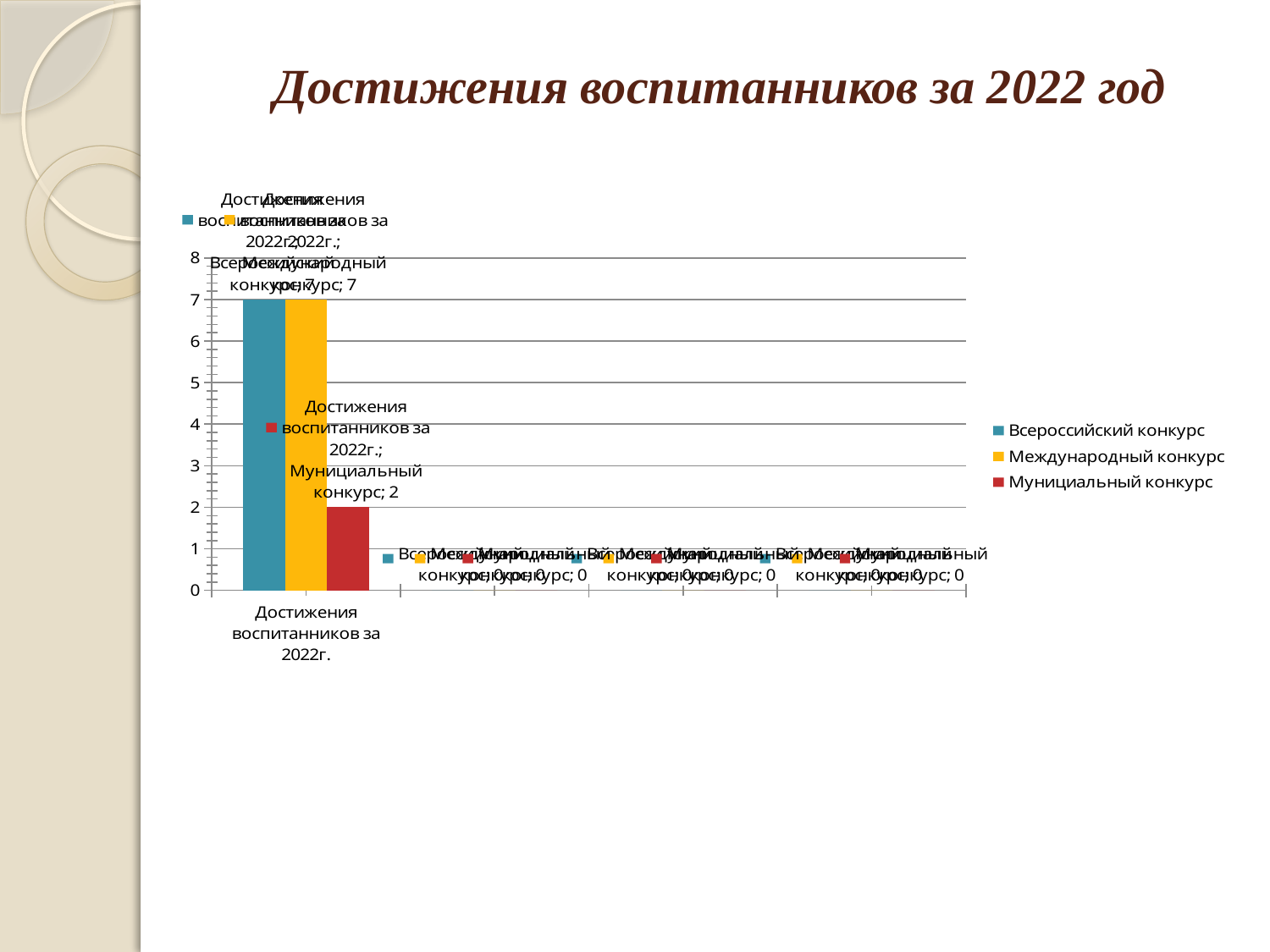
Is the value for Муниципальный конкурс greater or less than 4? less Which is larger, the value for Международный конкурс or the value for Муниципальный конкурс? Международный конкурс What is the title of the slide? Достижения воспитанников за 2022 год What is the difference between the values for Международный конкурс and Муниципальный конкурс? 5 What kind of chart is shown on the slide? bar chart Which series has the lowest value in the chart? Муниципальный конкурс What is the value for Международный конкурс in the chart? 7 What is the difference between the values for Всероссийский конкурс and Муниципальный конкурс? 5 How many series does the legend list? 3 What is the value for Всероссийский конкурс in the chart? 7 Is the value for Всероссийский конкурс greater or less than 5? greater What is the value for Муниципальный конкурс in the chart? 2